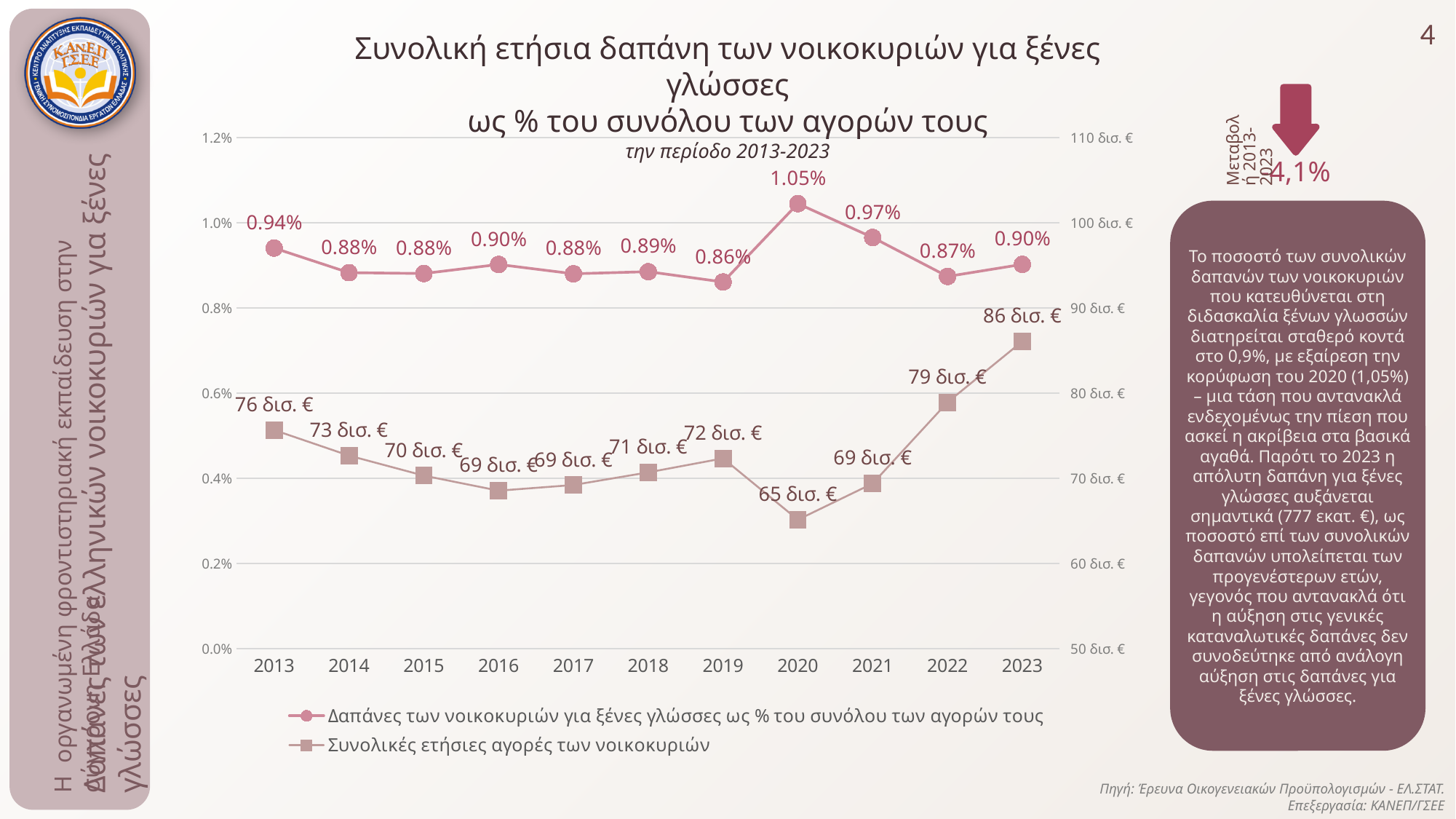
What was the households' spending on foreign languages as a % of their total purchases in 2020? 1.05% How many series does the chart legend list? 2 What is the difference in total annual household purchases between 2023 and 2022? 7 δισ. € What were the total annual household purchases (Συνολικές ετήσιες αγορές των νοικοκυριών) in 2023? 86 δισ. € In which year was the share of household spending on foreign languages highest? 2020 What kind of chart is shown on the slide? Line chart What was the households' spending on foreign languages as a % of their total purchases in 2013? 0.94% Did total annual household purchases rise or fall from 2020 to 2023? Rise In which year was the share of household spending on foreign languages lowest? 2019 In which year were total annual household purchases lowest? 2020 Which year had a higher share of spending on foreign languages, 2021 or 2023? 2021 How many years are shown on the x axis of the chart? 11